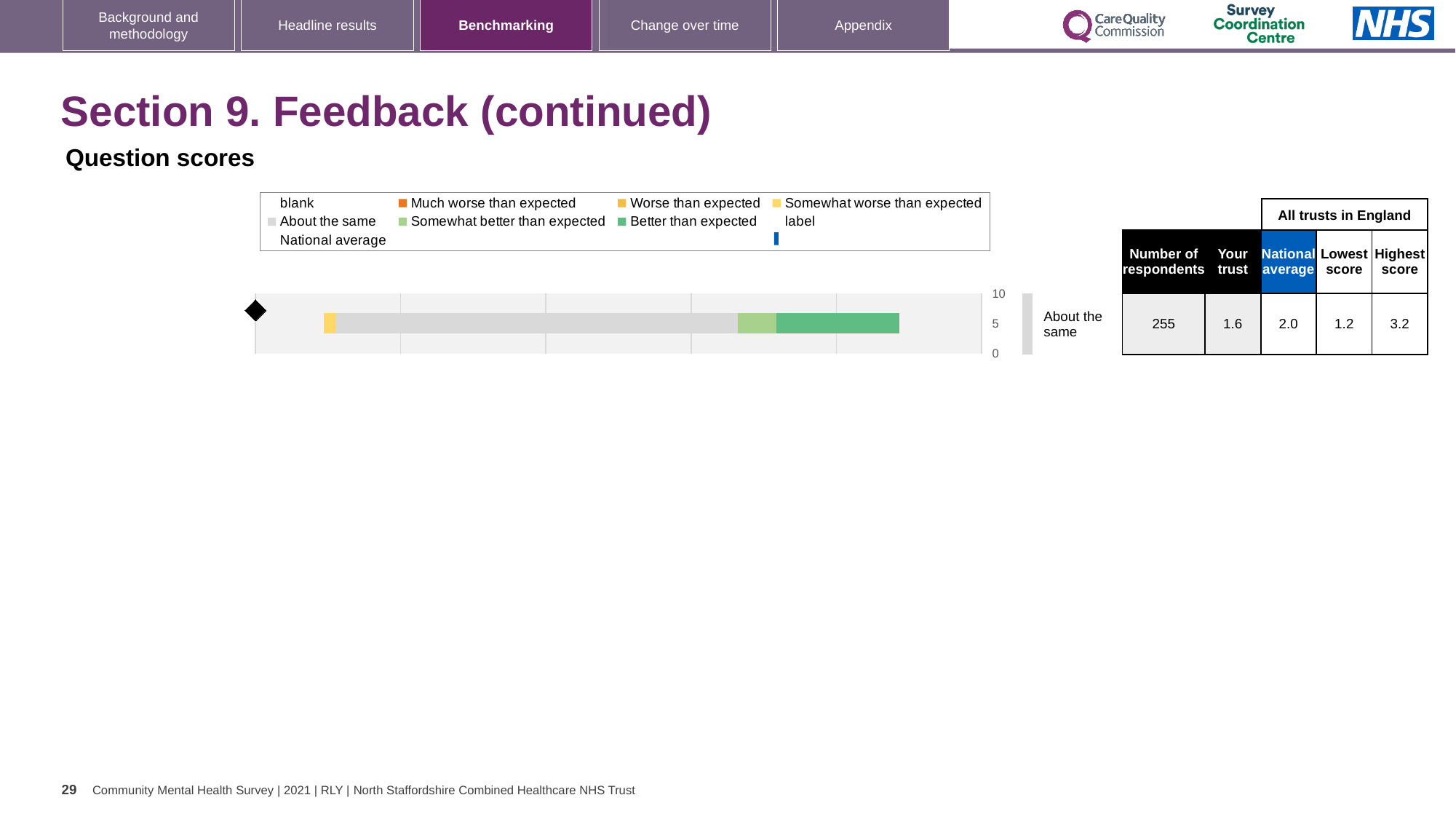
In the table beside the chart, what is the National average score? 2.0 Which legend category does the grey segment of the bar represent? About the same How many entries does the chart's legend list? 9 How many bars are plotted in the chart? 1 What is the highest value shown on the chart's axis? 10 In the table beside the chart, what is the Lowest score among all trusts in England? 1.2 In the table beside the chart, which is larger: the Your trust score or the National average? National average In the table beside the chart, what is the number of respondents? 255 In the table beside the chart, what is the score for Your trust? 1.6 In the table beside the chart, what is the Highest score among all trusts in England? 3.2 In the table beside the chart, what is the difference between the Highest score and the Lowest score? 2.0 What kind of chart is shown on the slide? bar chart